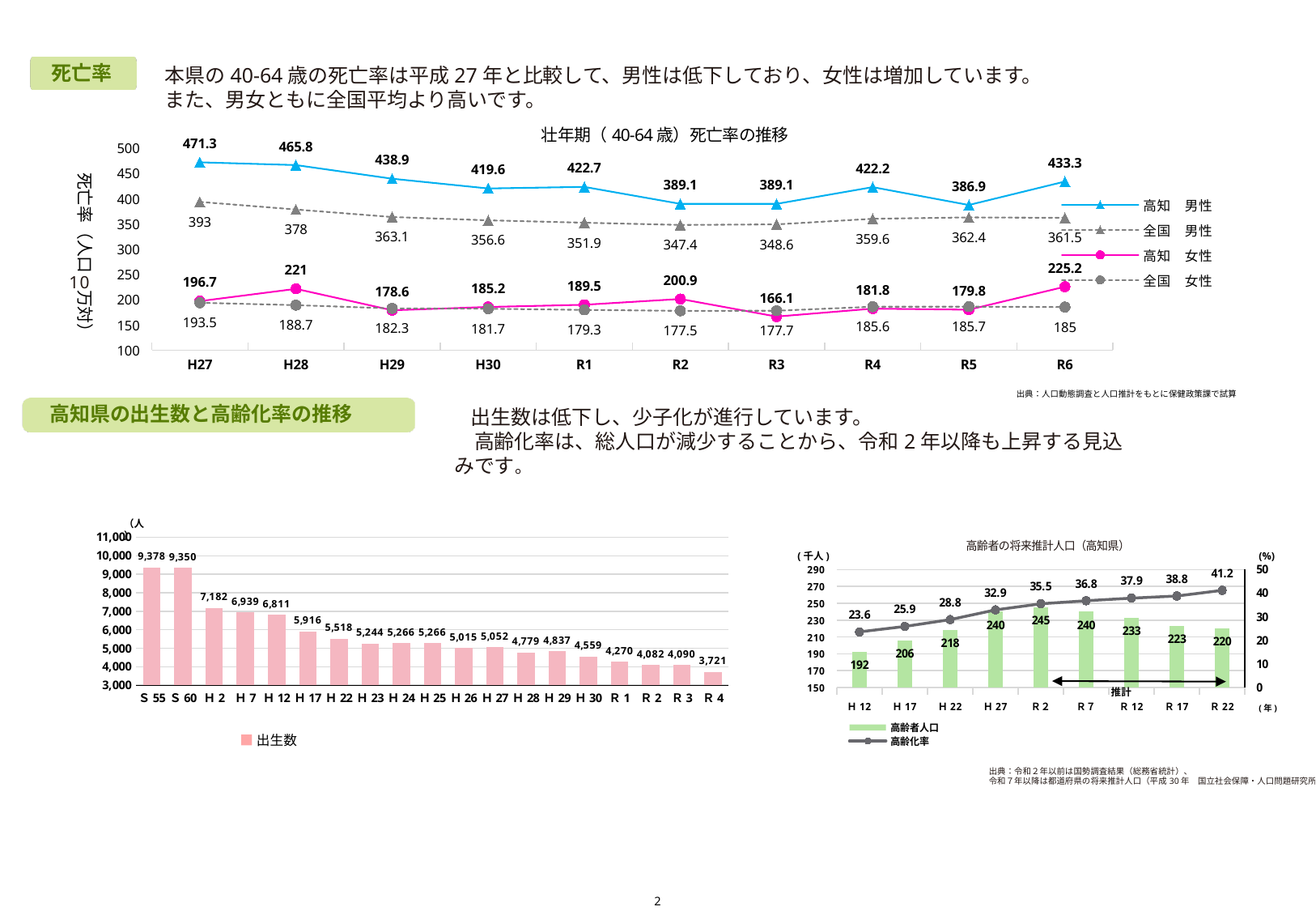
In the bottom-right chart 高齢者の将来推計人口（高知県）, what is the 高齢者人口 value for R 2? 245 In the top chart 壮年期（40-64歳）死亡率の推移, which is larger in R6: 高知 女性 or 全国 女性? 高知 女性 In the bottom-right chart 高齢者の将来推計人口（高知県）, what is the 高齢化率 value for R 22? 41.2 In the bottom-right chart 高齢者の将来推計人口（高知県）, does 高齢化率 rise or fall from H 12 to R 22? rise In the top chart 壮年期（40-64歳）死亡率の推移, how many series does the legend list? 4 In the bottom-left chart of 出生数, which category has the lowest value? R 4 In the top chart 壮年期（40-64歳）死亡率の推移, in which year is 高知 女性 lowest? R3 In the top chart 壮年期（40-64歳）死亡率の推移, what is the value for 高知 男性 in H27? 471.3 In the top chart 壮年期（40-64歳）死亡率の推移, what is the value for 全国 男性 in R2? 347.4 In the top chart 壮年期（40-64歳）死亡率の推移, what is the difference between the 高知 男性 values in H27 and R6? 38.0 What kind of chart is the bottom-left chart of 出生数? bar chart In the bottom-left chart of 出生数, what is the value for S 55? 9,378